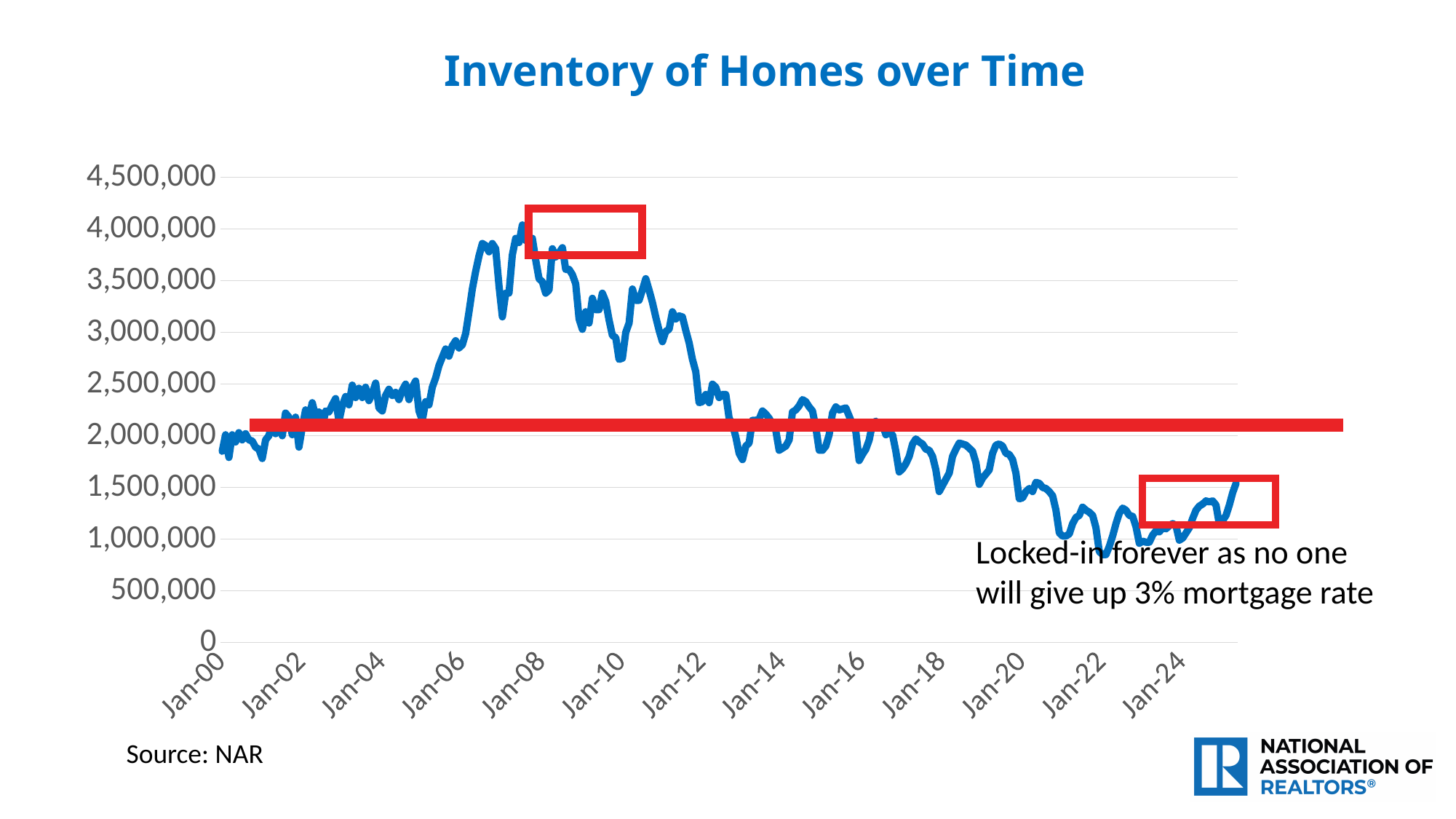
Is the inventory value at Jan-04 greater or less than 3,000,000? less What is the title of the chart? Inventory of Homes over Time Do inventory values generally rise or fall between Jan-08 and Jan-22? fall How many labels are shown on the x axis? 13 What source is cited for the chart? NAR Is the inventory value at Jan-20 greater or less than 2,500,000? less Around which x-axis label does the inventory reach its highest point? Jan-08 Which is larger, the inventory around Jan-08 or the inventory around Jan-22? Jan-08 Is the inventory value around Jan-22 greater or less than 1,500,000? less What kind of chart is shown on the slide? line chart